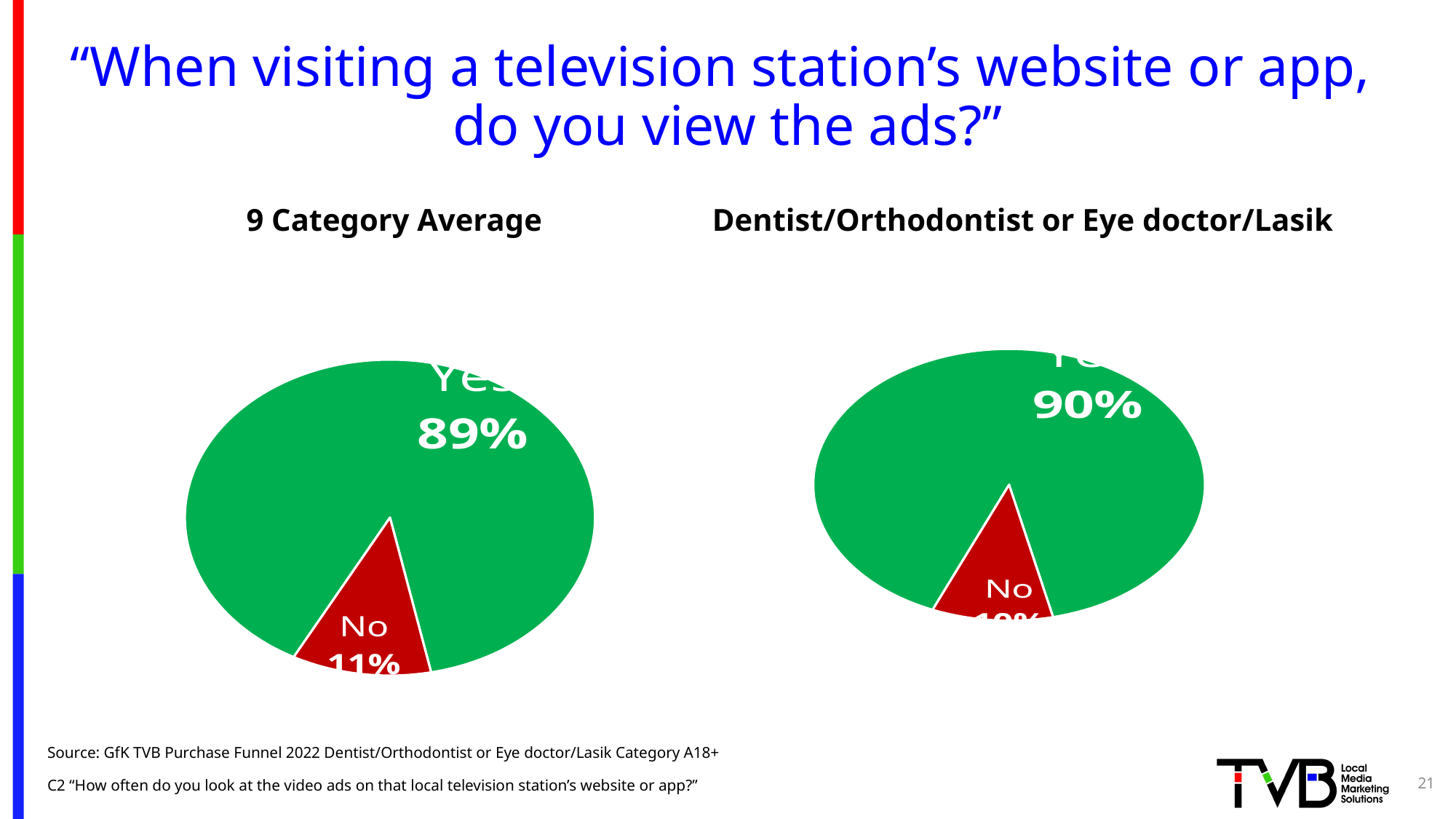
How many slices does the 9 Category Average pie chart have? 2 In the Dentist/Orthodontist or Eye doctor/Lasik pie chart, what percentage answered Yes? 90% In the 9 Category Average pie chart, which response has the larger share? Yes Is the Yes share higher in the 9 Category Average chart or in the Dentist/Orthodontist or Eye doctor/Lasik chart? Dentist/Orthodontist or Eye doctor/Lasik What kind of chart is used for the 9 Category Average data? Pie chart In the Dentist/Orthodontist or Eye doctor/Lasik pie chart, which response has the smaller share? No In the 9 Category Average pie chart, what is the difference in percentage points between the Yes and No shares? 78 percentage points What is the difference in percentage points between the Yes share in the Dentist/Orthodontist or Eye doctor/Lasik chart and the Yes share in the 9 Category Average chart? 1 percentage point What is the title above the left pie chart? 9 Category Average In the 9 Category Average pie chart, what percentage answered Yes? 89% What colour is the No slice in the pie charts? Red In the 9 Category Average pie chart, what percentage answered No? 11%